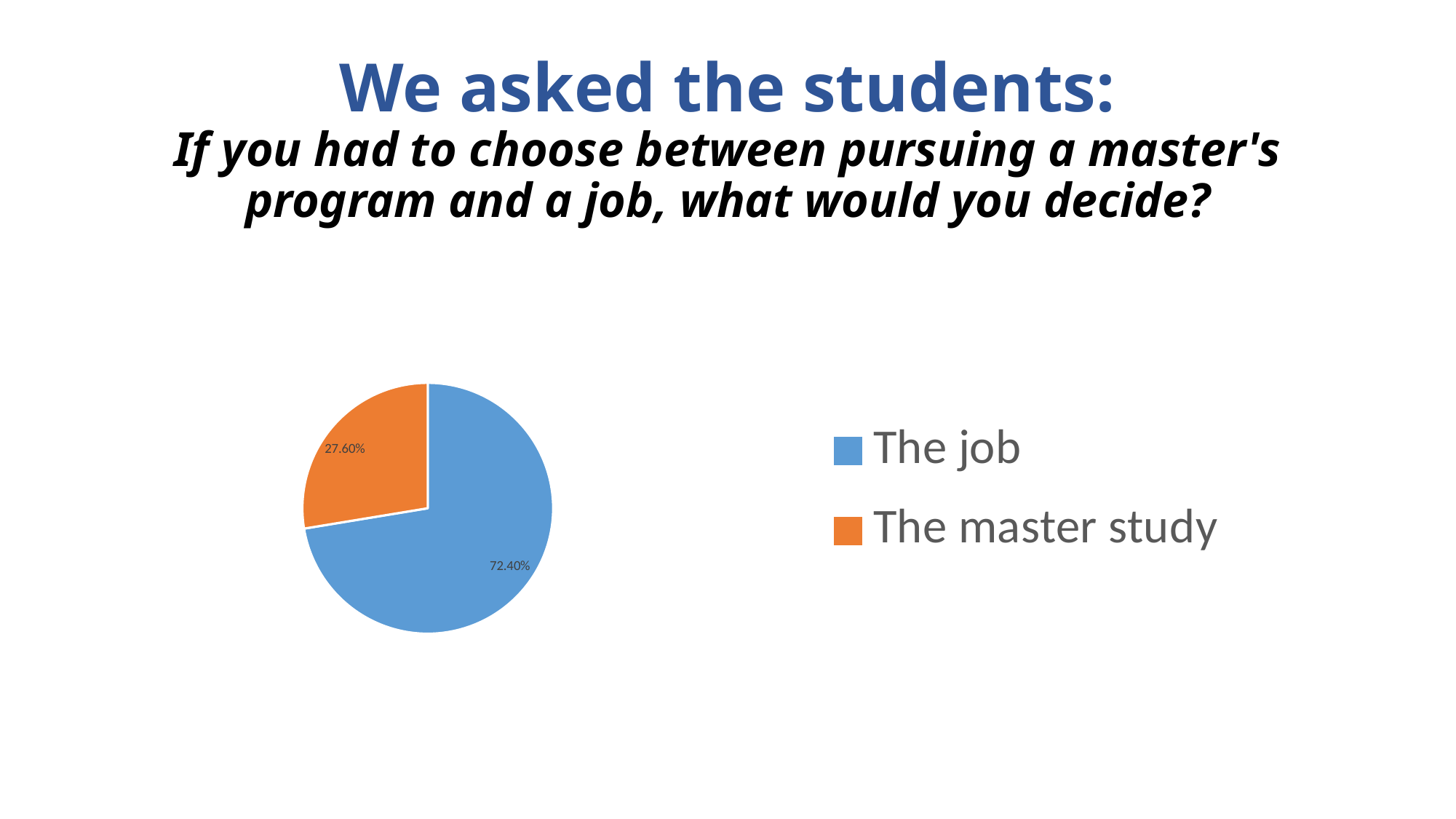
How many slices does the pie chart have? 2 What kind of chart is shown on the slide? pie chart Which option has the smallest share of the pie? The master study What colour is the slice for "The job"? blue What percentage of students chose "The job"? 72.40% How many entries does the legend list? 2 Which option has the largest share of the pie? The job What colour is the slice for "The master study"? orange What is the difference in percentage points between "The job" and "The master study"? 44.80% Which is larger: the share for "The job" or the share for "The master study"? The job What percentage of students chose "The master study"? 27.60%